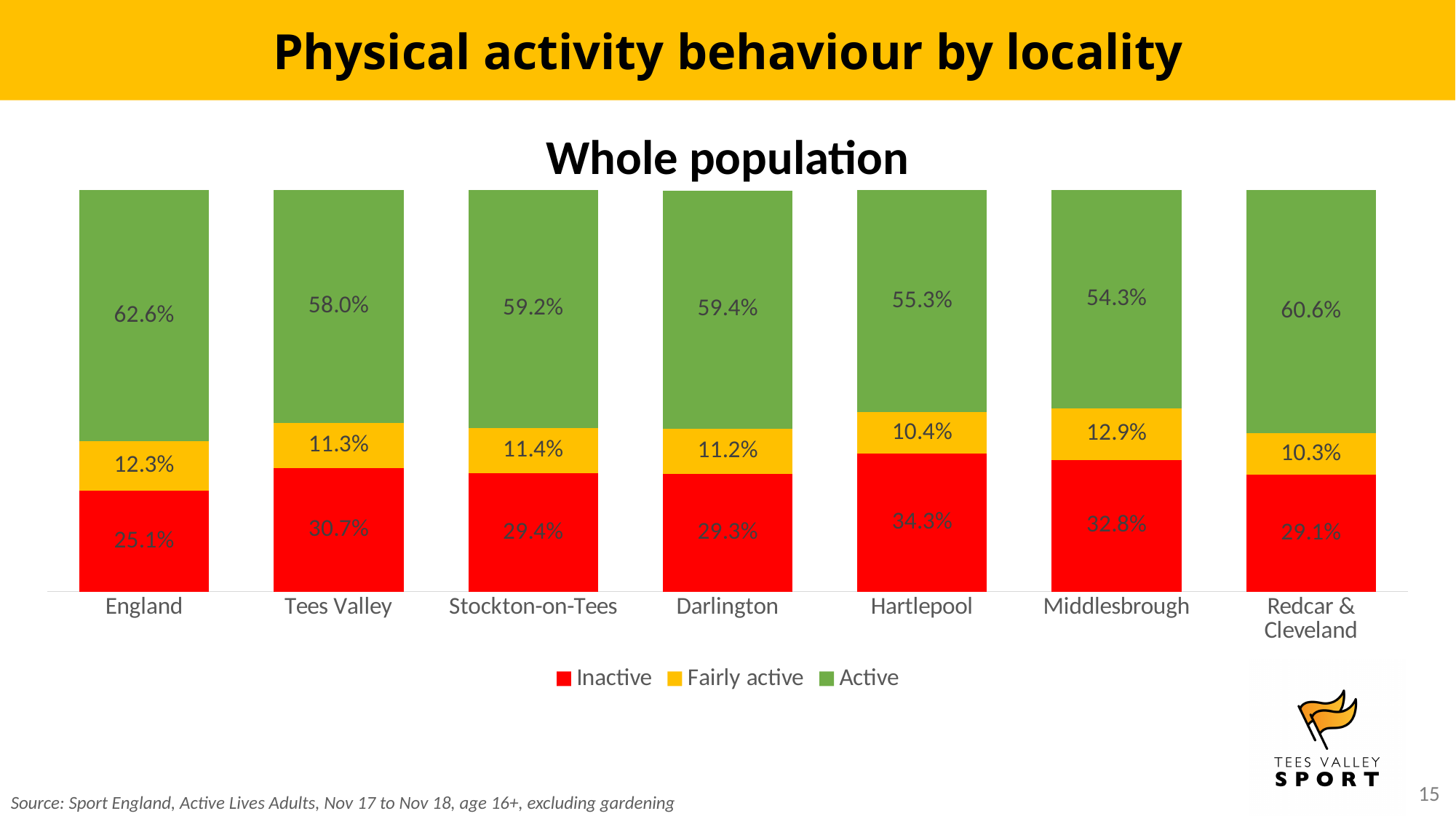
What is the Fairly active value for Darlington? 11.2% Which locality has the highest Inactive value? Hartlepool What is the difference between the Inactive value for Hartlepool and the Inactive value for England? 9.2 percentage points How many series does the legend list? 3 What is the Active value for Redcar & Cleveland? 60.6% What is the total of the stacked bar for Tees Valley? 100.0% Which locality has the lowest Active value? Middlesbrough Which locality has the highest Fairly active value? Middlesbrough What is the Inactive value for Hartlepool? 34.3% What kind of chart is shown? Stacked bar chart Which is larger, the Inactive value for Middlesbrough or the Inactive value for Tees Valley? Middlesbrough How many localities are shown on the x axis? 7